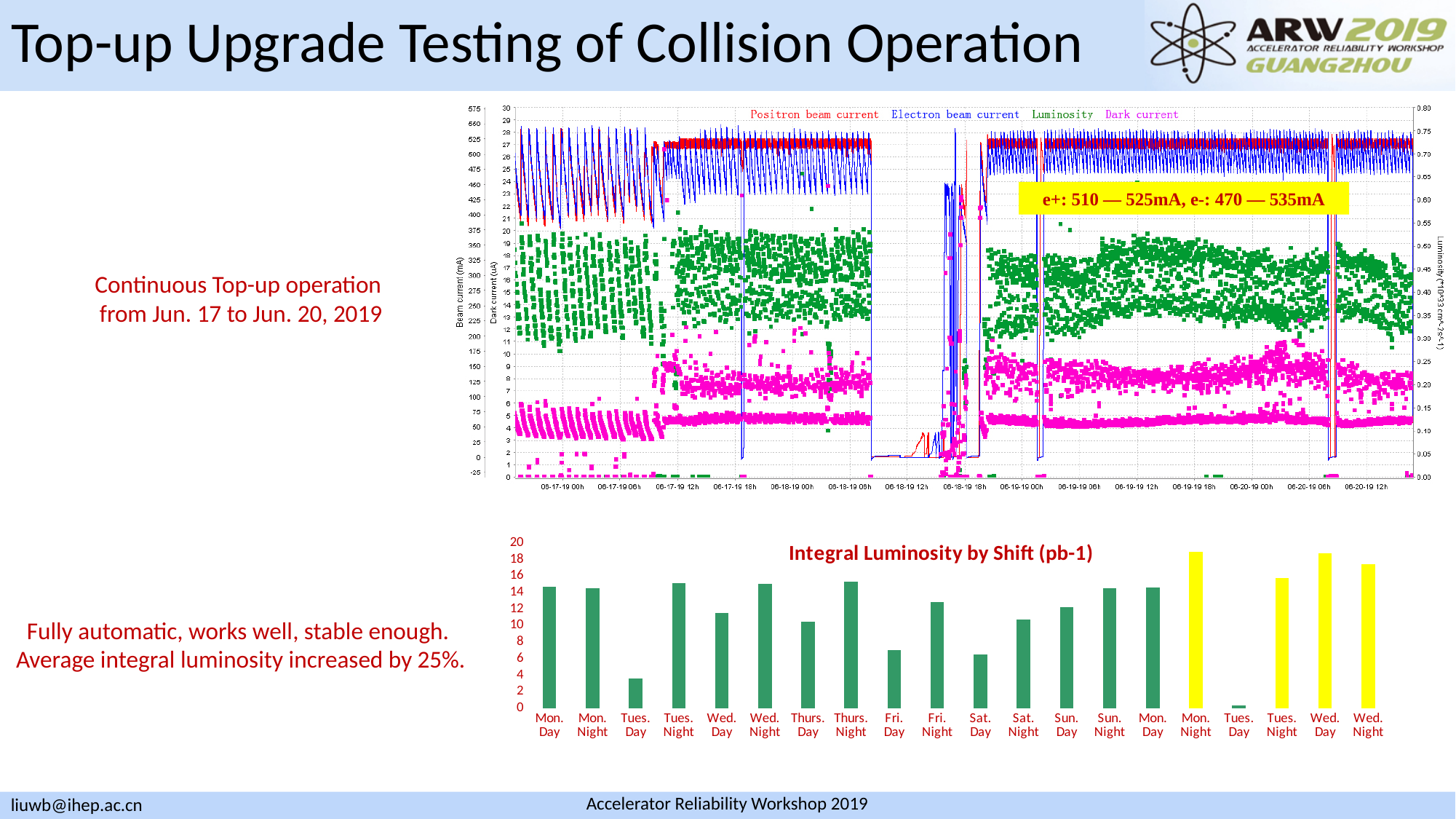
In the 'Integral Luminosity by Shift (pb-1)' chart, is the value for the yellow Wed. Day bar greater or less than 18? greater What kind of chart is the 'Integral Luminosity by Shift (pb-1)' chart at the bottom of the slide? bar chart In the 'Integral Luminosity by Shift (pb-1)' chart, which is larger: the first Wed. Day bar or the first Tues. Day bar? Wed. Day In the 'Integral Luminosity by Shift (pb-1)' chart, what two colours are used for the bars? green and yellow In the 'Integral Luminosity by Shift (pb-1)' chart, is the value for the first Tues. Day bar greater or less than 4? less What are the series named in the legend of the top time-series chart? Positron beam current, Electron beam current, Luminosity, Dark current In the 'Integral Luminosity by Shift (pb-1)' chart, which is larger: Sat. Day or Sat. Night? Sat. Night In the 'Integral Luminosity by Shift (pb-1)' chart, which shift has the lowest integral luminosity? Tues. Day (the second one, next to Mon. Night in yellow) In the 'Integral Luminosity by Shift (pb-1)' chart, is the value for Fri. Day greater or less than 8? less How many shifts (bars) are shown in the 'Integral Luminosity by Shift (pb-1)' chart? 20 How many series does the legend of the top time-series chart list? 4